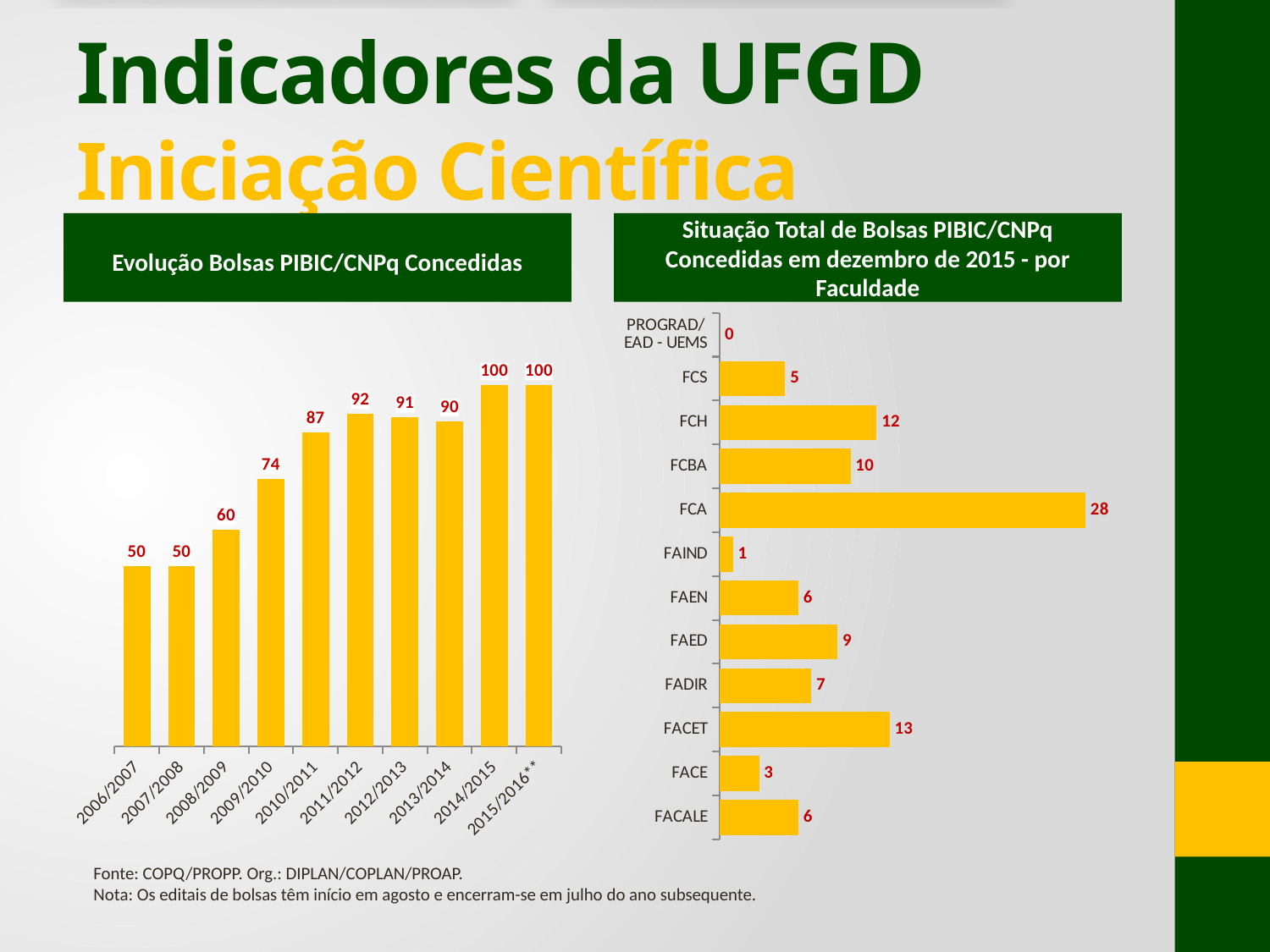
In the chart 'Situação Total de Bolsas PIBIC/CNPq Concedidas em dezembro de 2015 - por Faculdade', which is larger, the value for FCH or the value for FCBA? FCH In the chart 'Evolução Bolsas PIBIC/CNPq Concedidas', how many periods are shown on the x axis? 10 In the chart 'Situação Total de Bolsas PIBIC/CNPq Concedidas em dezembro de 2015 - por Faculdade', which faculty has the highest value? FCA In the chart 'Situação Total de Bolsas PIBIC/CNPq Concedidas em dezembro de 2015 - por Faculdade', what is the value for FACET? 13 In the chart 'Evolução Bolsas PIBIC/CNPq Concedidas', what is the value for 2012/2013? 91 In the chart 'Evolução Bolsas PIBIC/CNPq Concedidas', do the values generally rise or fall from 2006/2007 to 2015/2016**? rise In the chart 'Situação Total de Bolsas PIBIC/CNPq Concedidas em dezembro de 2015 - por Faculdade', how many faculties are listed? 12 In the chart 'Situação Total de Bolsas PIBIC/CNPq Concedidas em dezembro de 2015 - por Faculdade', what is the difference between the values for FCA and FAED? 19 In the chart 'Situação Total de Bolsas PIBIC/CNPq Concedidas em dezembro de 2015 - por Faculdade', what is the value for PROGRAD/EAD - UEMS? 0 In the chart 'Evolução Bolsas PIBIC/CNPq Concedidas', what is the difference between the values for 2010/2011 and 2008/2009? 27 In the chart 'Evolução Bolsas PIBIC/CNPq Concedidas', what is the value for 2009/2010? 74 What kind of chart is 'Evolução Bolsas PIBIC/CNPq Concedidas'? bar chart